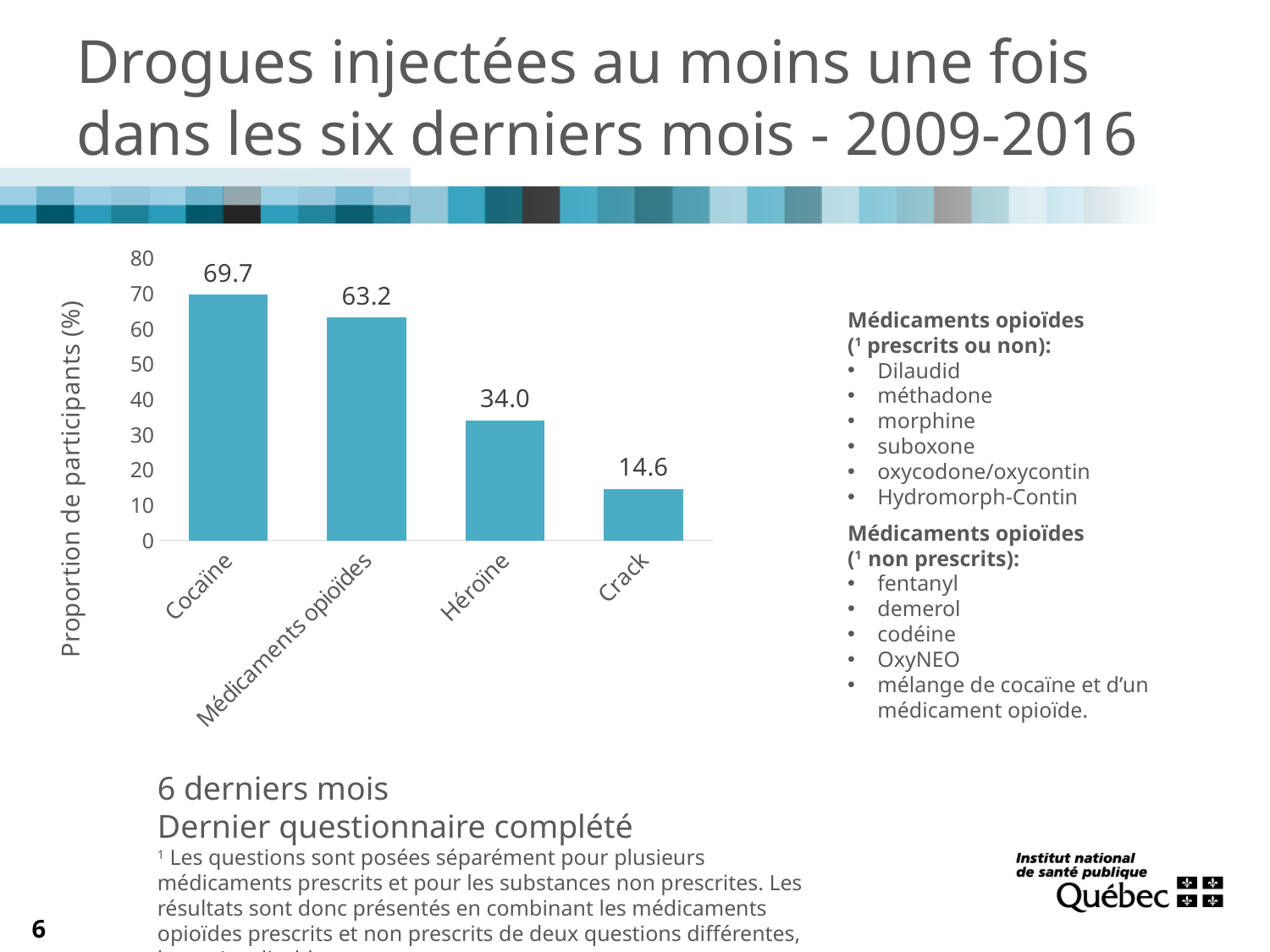
What is the value for Médicaments opioïdes? 63.2 What is the label of the vertical axis? Proportion de participants (%) What is the value for Cocaïne? 69.7 Which is larger, the value for Héroïne or the value for Crack? Héroïne What is the value for Héroïne? 34.0 Which category has the lowest value? Crack What is the difference between the values for Cocaïne and Médicaments opioïdes? 6.5 Which category has the highest value? Cocaïne What kind of chart is shown on the slide? Bar chart What is the difference between the values for Héroïne and Crack? 19.4 What is the value for Crack? 14.6 How many categories are shown in the chart? 4